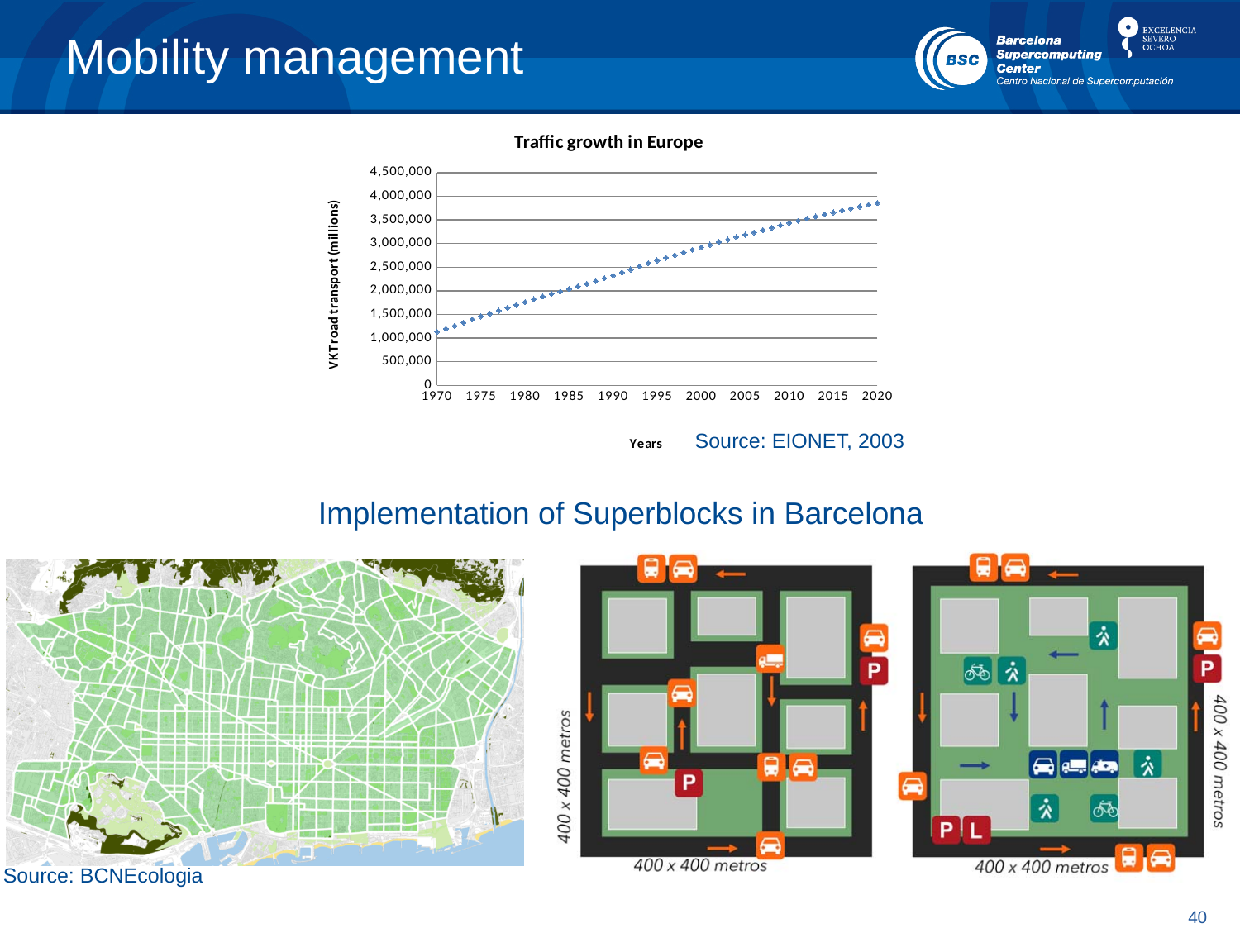
In the 'Traffic growth in Europe' chart, which is larger, the value for 1975 or the value for 2005? 2005 In the 'Traffic growth in Europe' chart, is the value for 1980 greater or less than 2,000,000? less In the 'Traffic growth in Europe' chart, which year has the highest value? 2020 In the 'Traffic growth in Europe' chart, is the value for 2020 greater or less than 4,000,000? less In the 'Traffic growth in Europe' chart, is the value for 1990 greater or less than 2,000,000? greater In the 'Traffic growth in Europe' chart, which year has the lowest value? 1970 What is the label of the vertical axis in the 'Traffic growth in Europe' chart? VKT road transport (millions) In the 'Traffic growth in Europe' chart, do the values rise or fall from 1970 to 2020? rise What kind of chart is 'Traffic growth in Europe'? scatter chart What is the title of the chart on the slide? Traffic growth in Europe